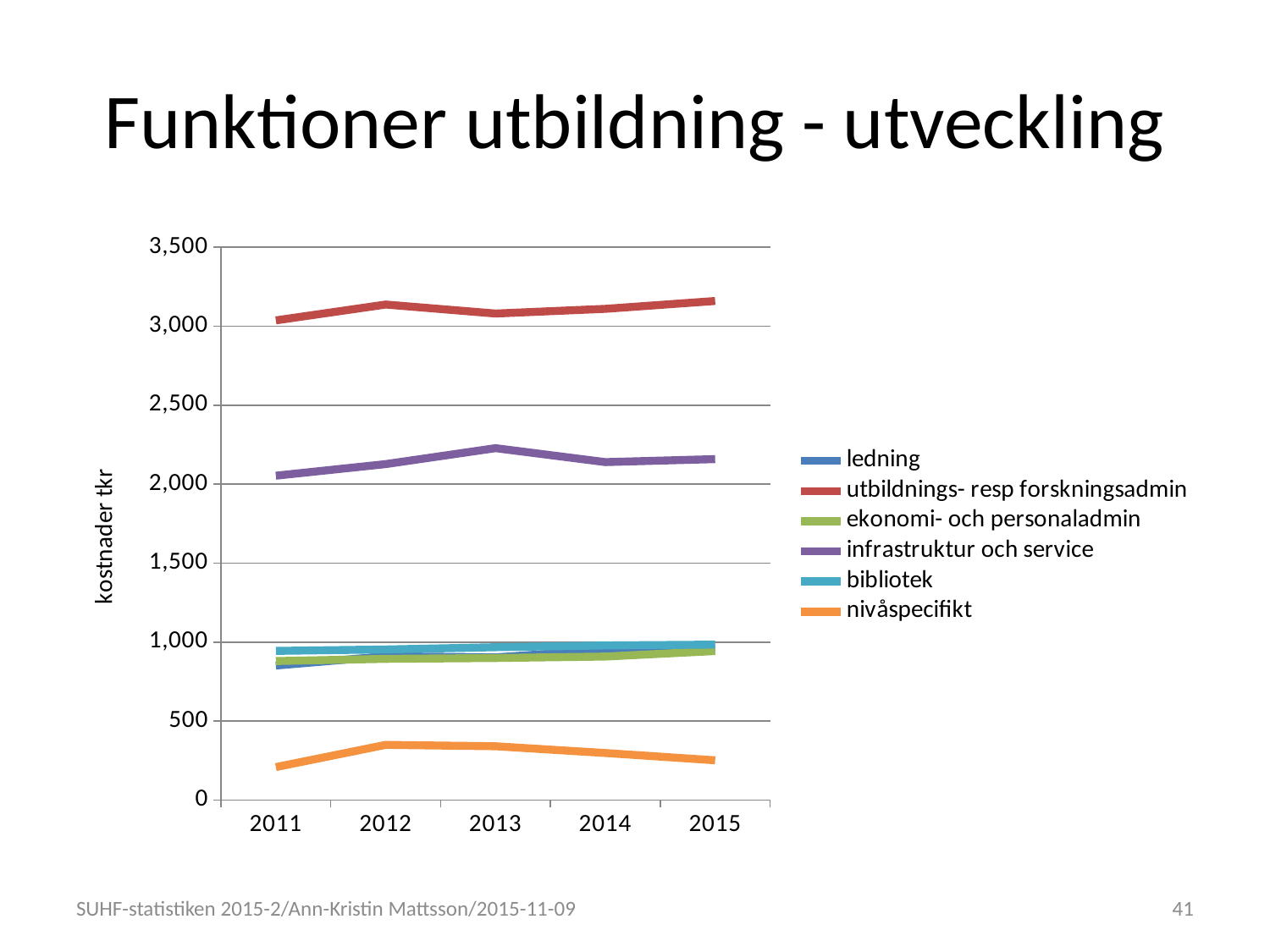
How many series does the legend list? 6 What kind of chart is shown on the slide? line chart Which series has the highest values across all years? utbildnings- resp forskningsadmin How many years are shown on the x axis? 5 Is the value for bibliotek in 2015 greater or less than 1,500? less Is the value for nivåspecifikt in 2012 greater or less than 500? less Does the value for nivåspecifikt rise or fall from 2012 to 2015? fall In which year does infrastruktur och service reach its highest value? 2013 What is the label on the y axis? kostnader tkr Is the value for utbildnings- resp forskningsadmin in 2011 greater or less than 2,500? greater Which series has the lowest values across all years? nivåspecifikt